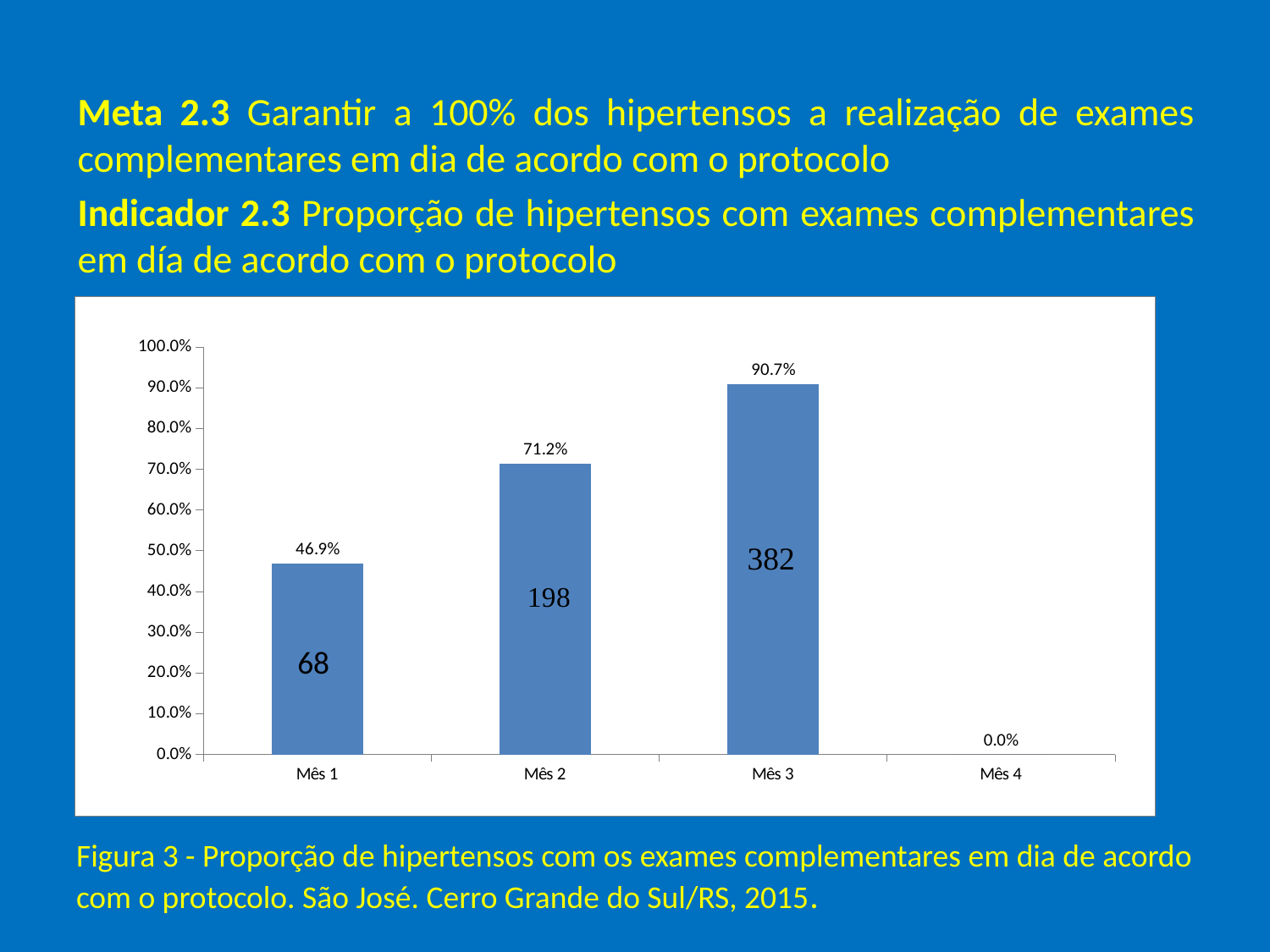
What is the value for Mês 1? 46.9% What number is printed inside the bar for Mês 2? 198 Which month has the highest value? Mês 3 Which month has the lowest value? Mês 4 What kind of chart is shown on the slide? Bar chart What is the value for Mês 4? 0.0% How many months are shown on the x axis? 4 What is the difference between the values for Mês 3 and Mês 1? 43.8% What is the value for Mês 2? 71.2% Which is larger, the value for Mês 2 or the value for Mês 1? Mês 2 What is the value for Mês 3? 90.7% What number is printed inside the bar for Mês 3? 382